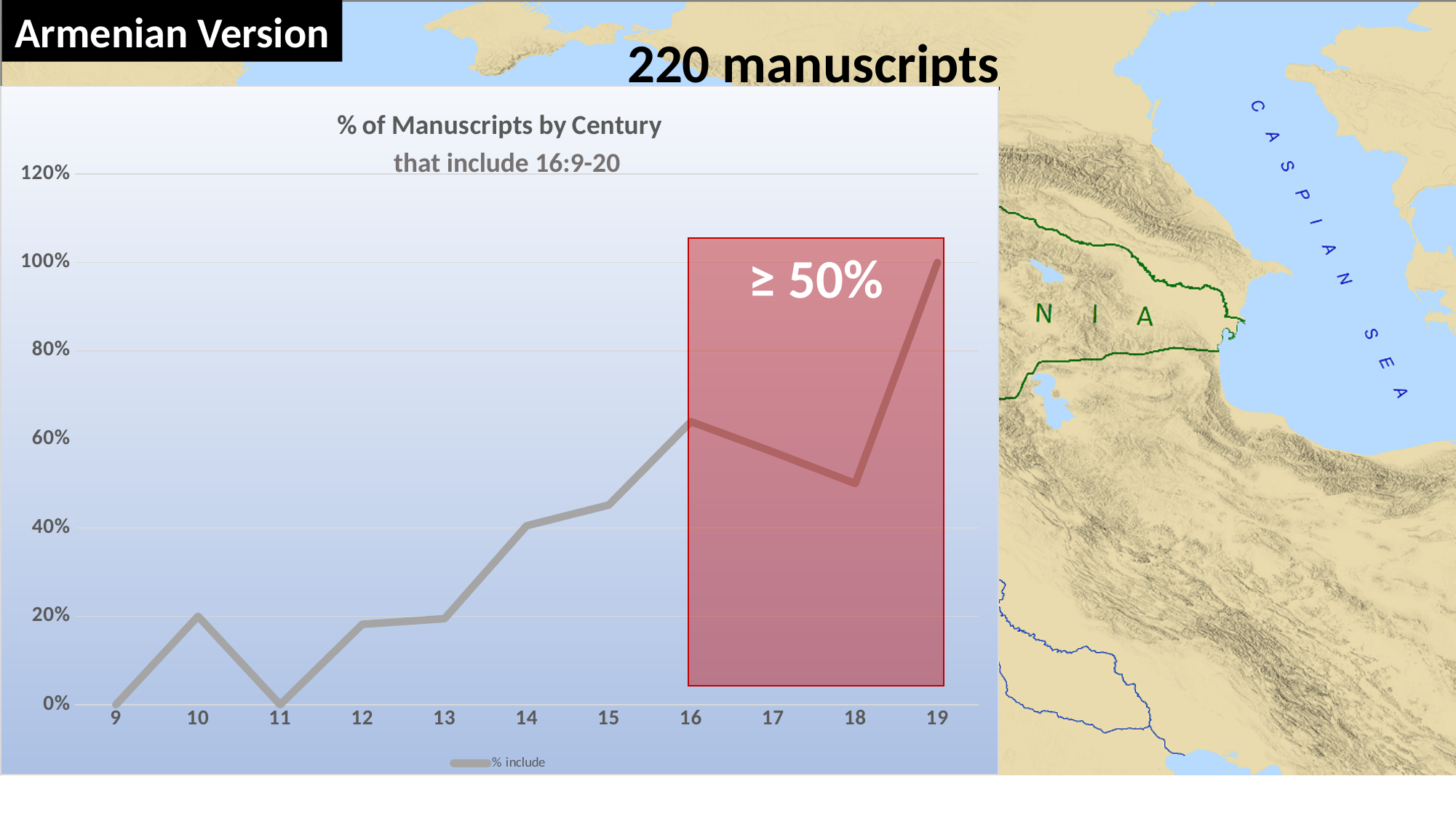
Which century has the highest value? 19 What kind of chart is shown on the slide? line chart What is the value for century 10? 20% How many series does the legend list? 1 Which has the larger value, century 16 or century 18? 16 What is the value for century 19? 100% How many centuries are plotted along the x axis? 11 What is the title of the chart? % of Manuscripts by Century that include 16:9-20 What is the difference between the values for century 19 and century 10? 80% Do the values rise or fall from century 16 to century 18? fall Is the value for century 16 greater or less than 60%? greater What is the value for century 9? 0%